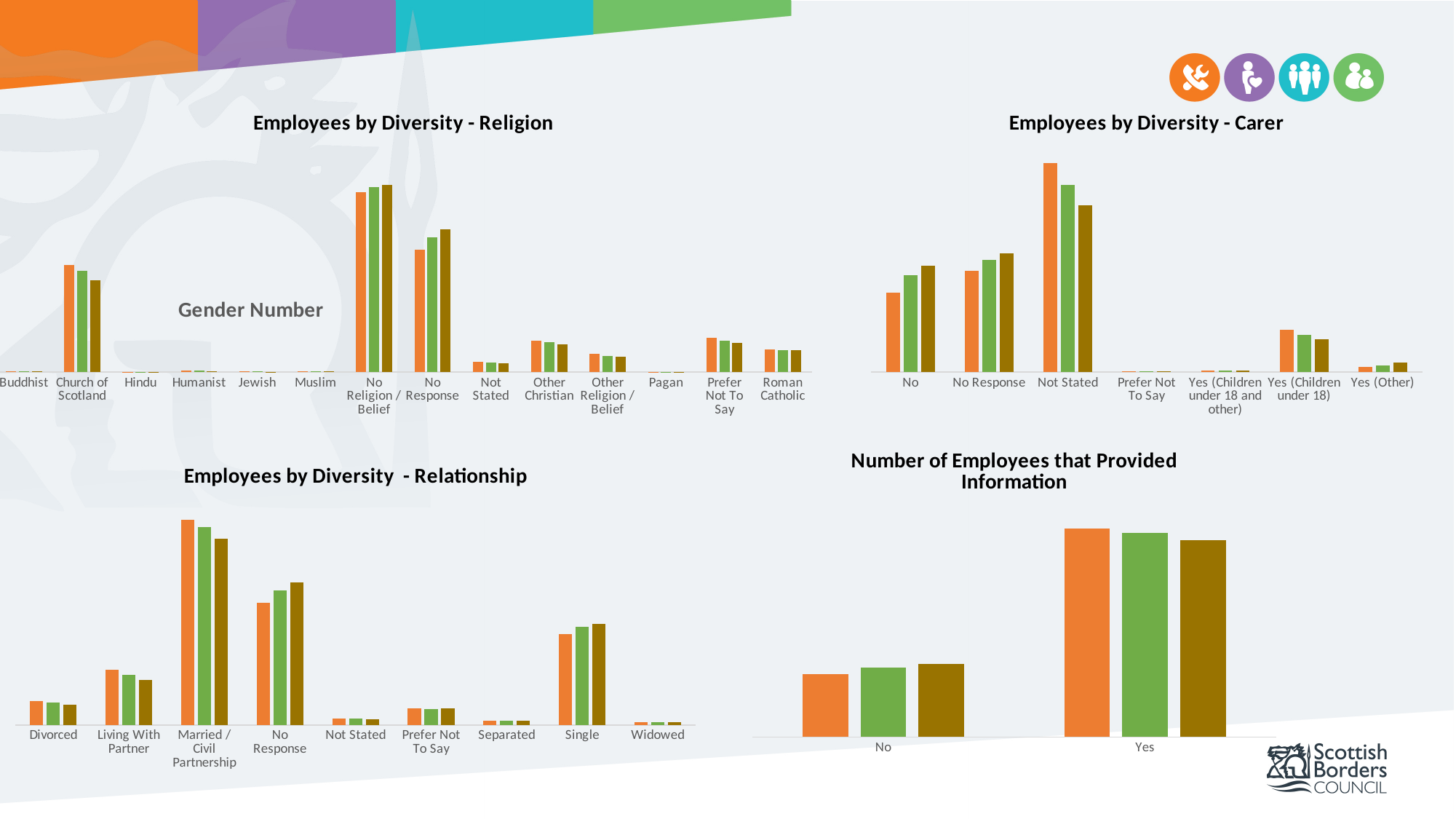
In the 'Employees by Diversity - Carer' chart, which category has the highest bars? Not Stated How many charts are shown on the slide? 4 What kind of chart is 'Employees by Diversity - Religion'? bar chart In the 'Employees by Diversity - Relationship' chart, how many categories are shown on the x axis? 9 In the 'Number of Employees that Provided Information' chart, which category has the higher bars, No or Yes? Yes In the 'Employees by Diversity - Carer' chart, how many categories are shown on the x axis? 7 In the 'Employees by Diversity - Religion' chart, which is larger, Church of Scotland or Roman Catholic? Church of Scotland In the 'Employees by Diversity - Carer' chart, which is larger, Yes (Children under 18) or Yes (Other)? Yes (Children under 18) In the 'Employees by Diversity - Relationship' chart, which category has the highest bars? Married / Civil Partnership In the 'Employees by Diversity - Religion' chart, how many categories are shown on the x axis? 14 In the 'Employees by Diversity - Relationship' chart, which is larger, Single or No Response? No Response